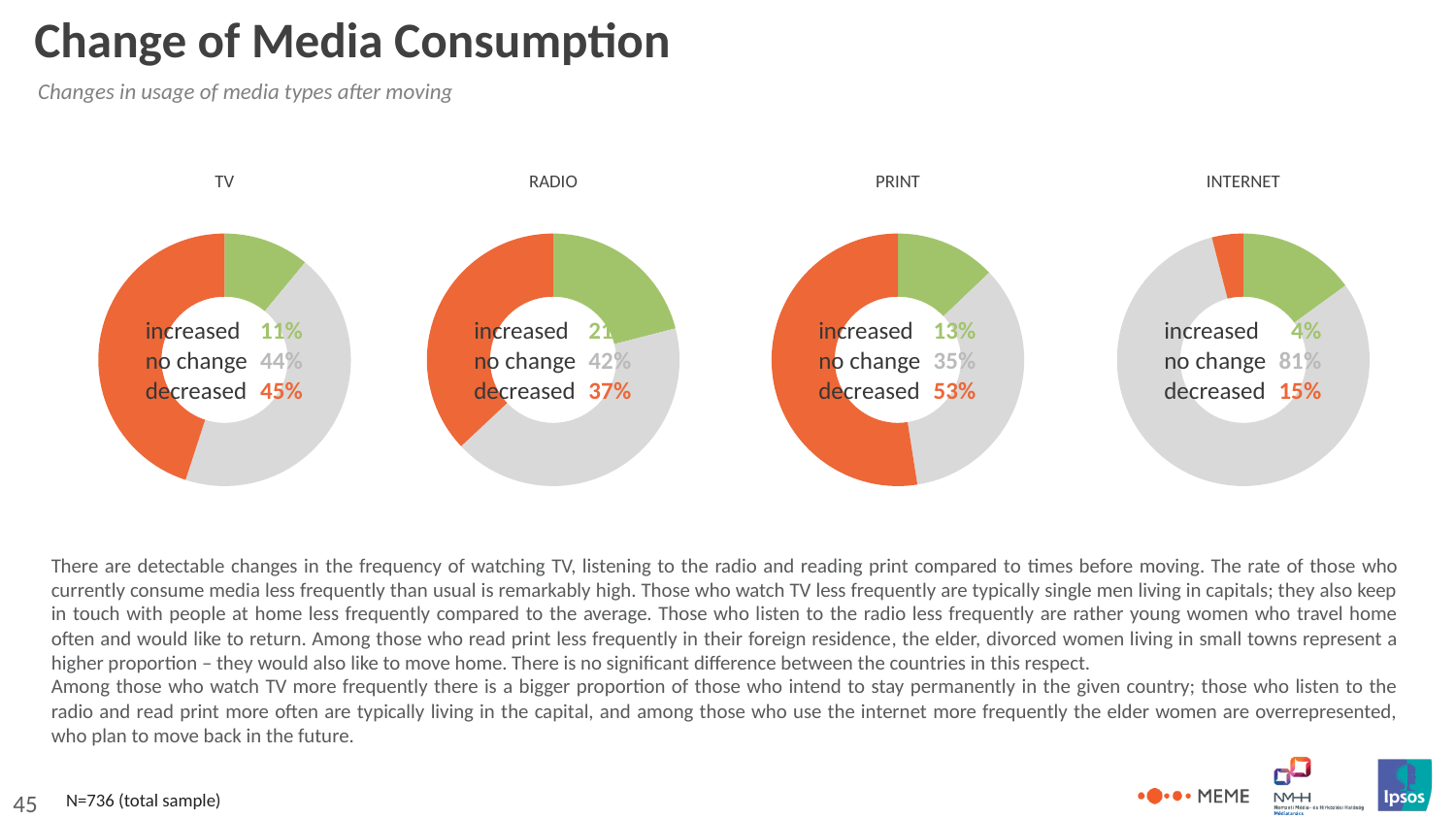
In the TV chart, which is larger: the share for no change or the share for increased? no change In the PRINT chart, what is the difference between the decreased and no change percentages? 18% What colour represents the 'decreased' category in the charts? Orange In the TV chart, what percentage of respondents said their usage decreased? 45% In the INTERNET chart, which category has the smallest share? increased In the RADIO chart, what percentage of respondents said their usage decreased? 37% In the INTERNET chart, what percentage of respondents reported no change? 81% Across the four charts, which media type has the highest percentage of respondents reporting decreased usage? PRINT In the PRINT chart, which category has the largest share? decreased How many donut charts are shown on the slide? 4 What type of chart is used to show the change in media consumption for each media type? Donut (pie) chart In the PRINT chart, what percentage of respondents said their usage increased? 13%